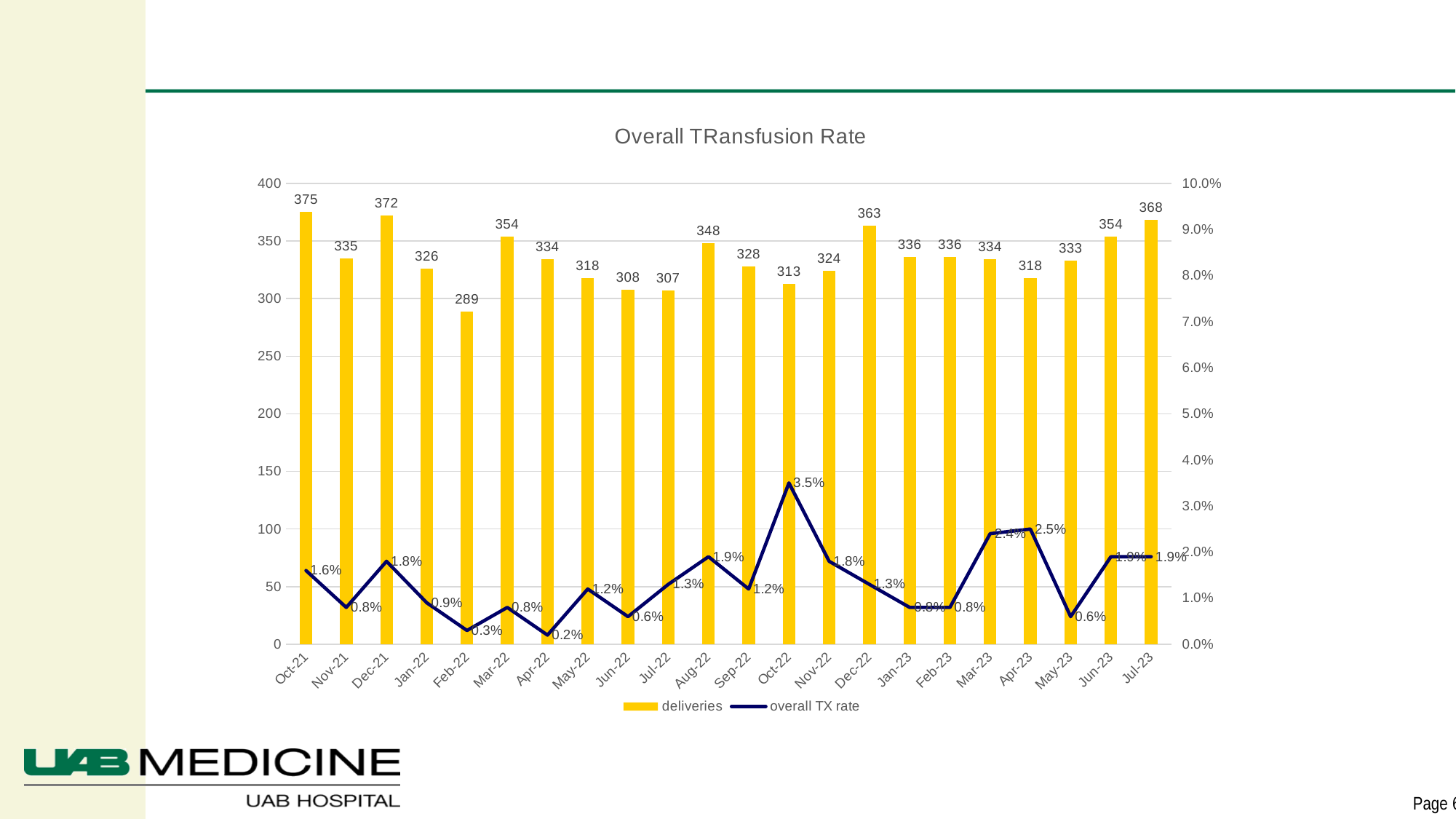
How many series does the legend list? 2 What is the number of deliveries for Aug-22? 348 What is the overall TX rate for Oct-22? 3.5% What is the overall TX rate for Apr-23? 2.5% What is the title of the chart? Overall TRansfusion Rate Which month has the lowest overall TX rate? Apr-22 What is the number of deliveries for Feb-22? 289 Which is larger, the deliveries for Jul-23 or for Dec-21? Dec-21 How many months are plotted on the x axis? 22 What colour are the deliveries bars? Yellow What is the difference in deliveries between Dec-22 and Oct-22? 50 Which month has the highest number of deliveries? Oct-21